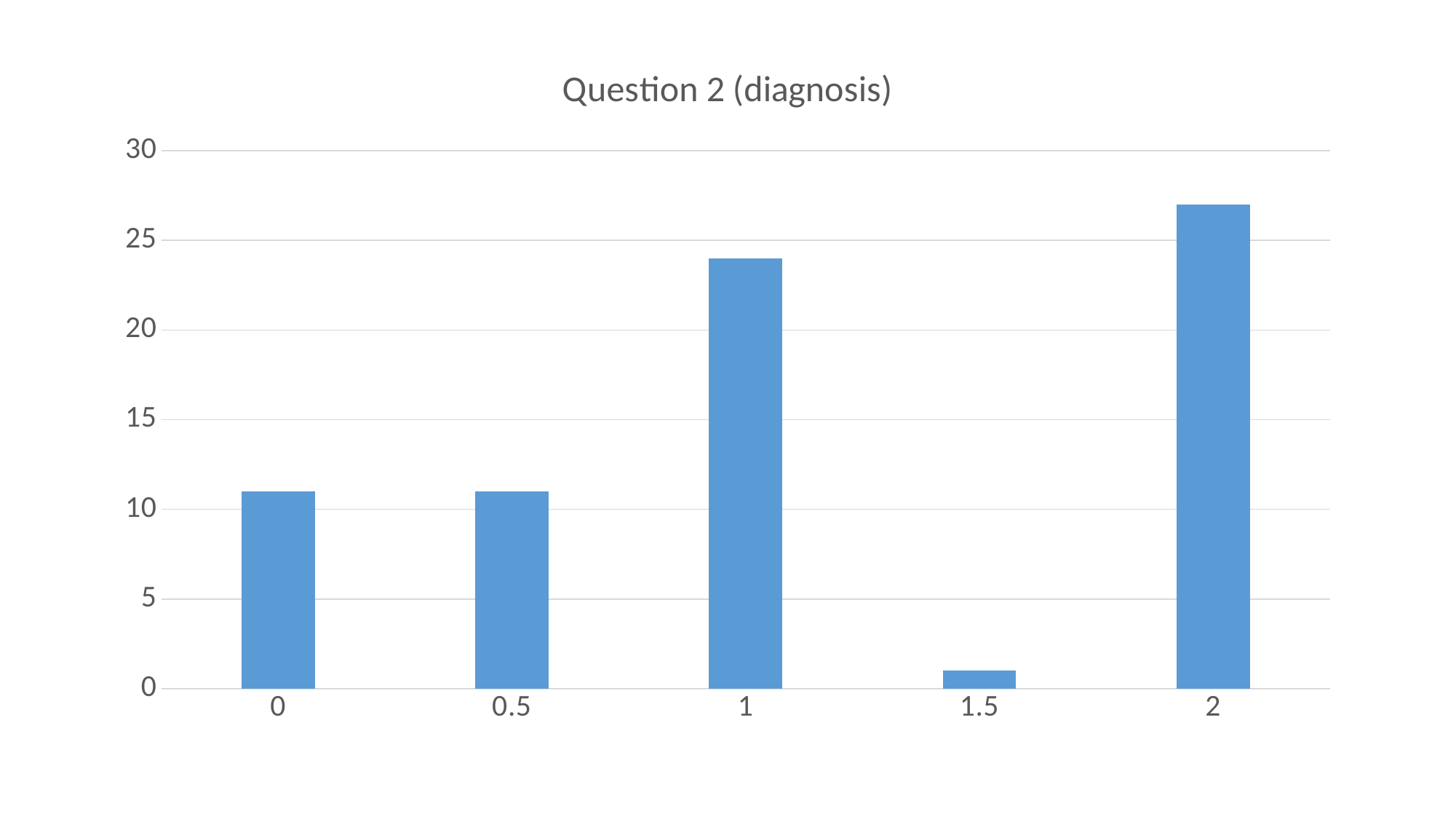
Is the value for category 2 greater or less than 25? greater Which category has the highest bar? 2 What kind of chart is shown on the slide? bar chart Which is larger, the value for category 1 or the value for category 0.5? 1 Which is larger, the value for category 1.5 or the value for category 0? 0 What is the title of the chart? Question 2 (diagnosis) Is the value for category 1.5 greater or less than 5? less Is the value for category 1 greater or less than 20? greater Which category has the lowest bar? 1.5 How many categories are shown on the x axis? 5